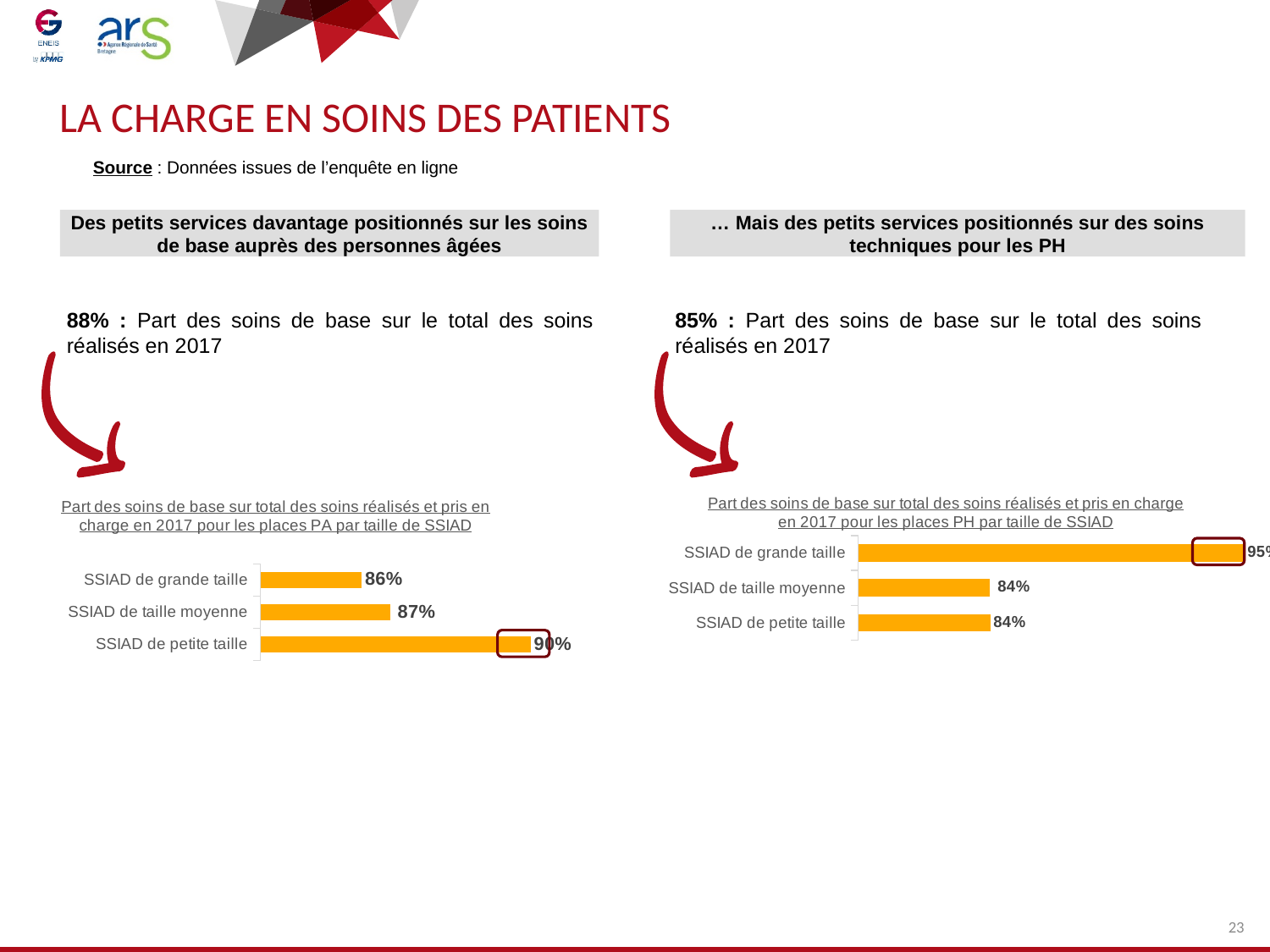
In the right chart (places PH), which category has the highest value? SSIAD de grande taille In the left chart (places PA), what is the value for SSIAD de petite taille? 90% In the left chart (places PA), which category has the highest value? SSIAD de petite taille What kind of chart is the right chart (places PH)? Bar chart In the right chart (places PH), what is the value for SSIAD de petite taille? 84% In the left chart (places PA), what is the value for SSIAD de grande taille? 86% In the left chart (places PA), what is the difference between SSIAD de petite taille and SSIAD de grande taille? 4% In the right chart (places PH), what is the value for SSIAD de taille moyenne? 84% In the left chart (places PA), what is the value for SSIAD de taille moyenne? 87% How many categories does the left chart (places PA) show? 3 What colour are the bars in the left chart (places PA)? Orange In the right chart (places PH), which is larger: SSIAD de grande taille or SSIAD de petite taille? SSIAD de grande taille